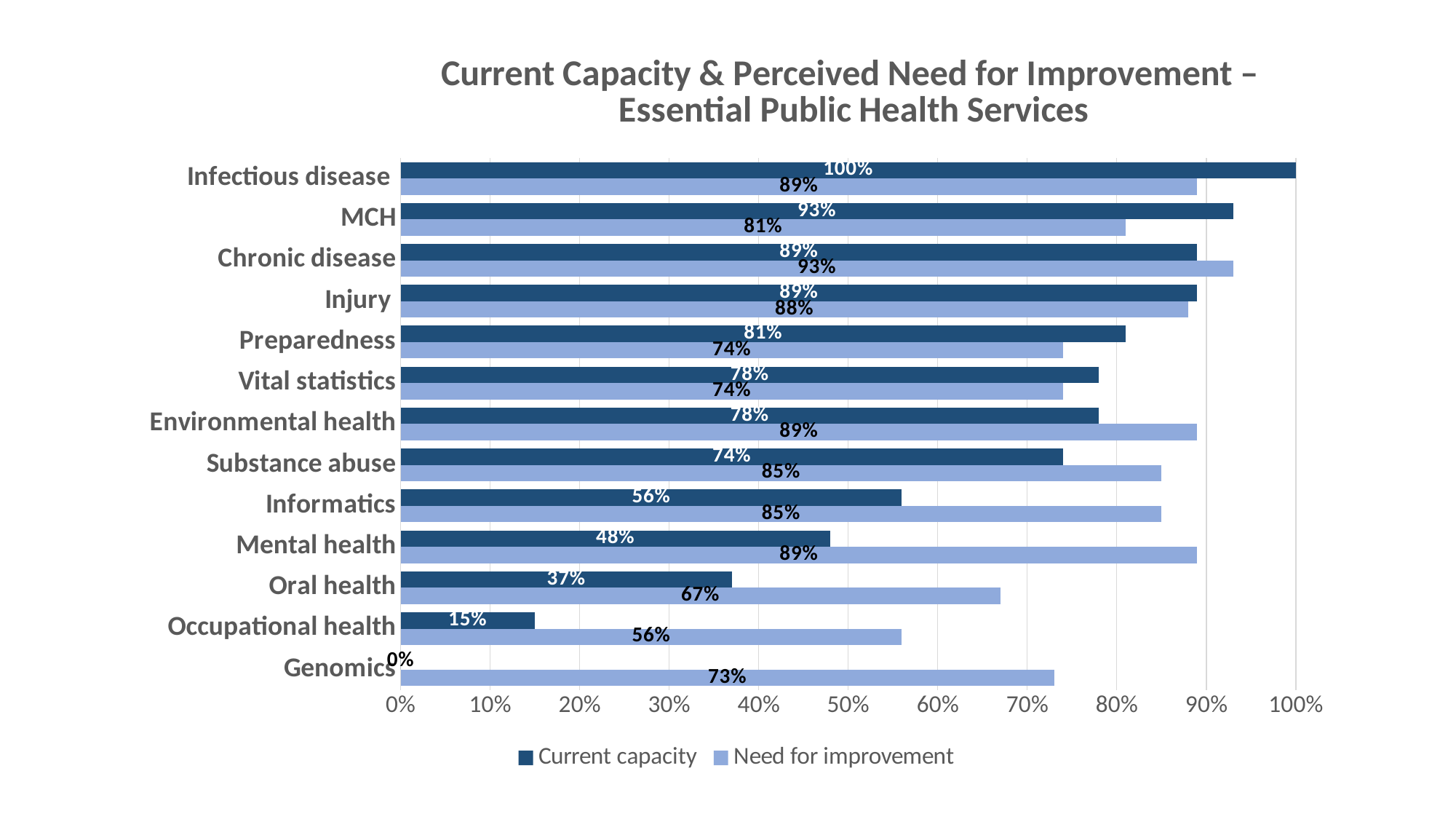
What is the Current capacity value for Mental health? 48% What is the Need for improvement value for Oral health? 67% What is the Need for improvement value for Genomics? 73% What kind of chart is shown on the slide? Bar chart How many categories are shown on the chart? 13 Which is larger for Informatics: Current capacity or Need for improvement? Need for improvement What is the difference between Need for improvement and Current capacity for Occupational health? 41% Which category has the lowest Need for improvement? Occupational health What is the title of the chart? Current Capacity & Perceived Need for Improvement – Essential Public Health Services Which category has the highest Current capacity? Infectious disease Which category has the lowest Current capacity? Genomics How many series does the legend list? 2